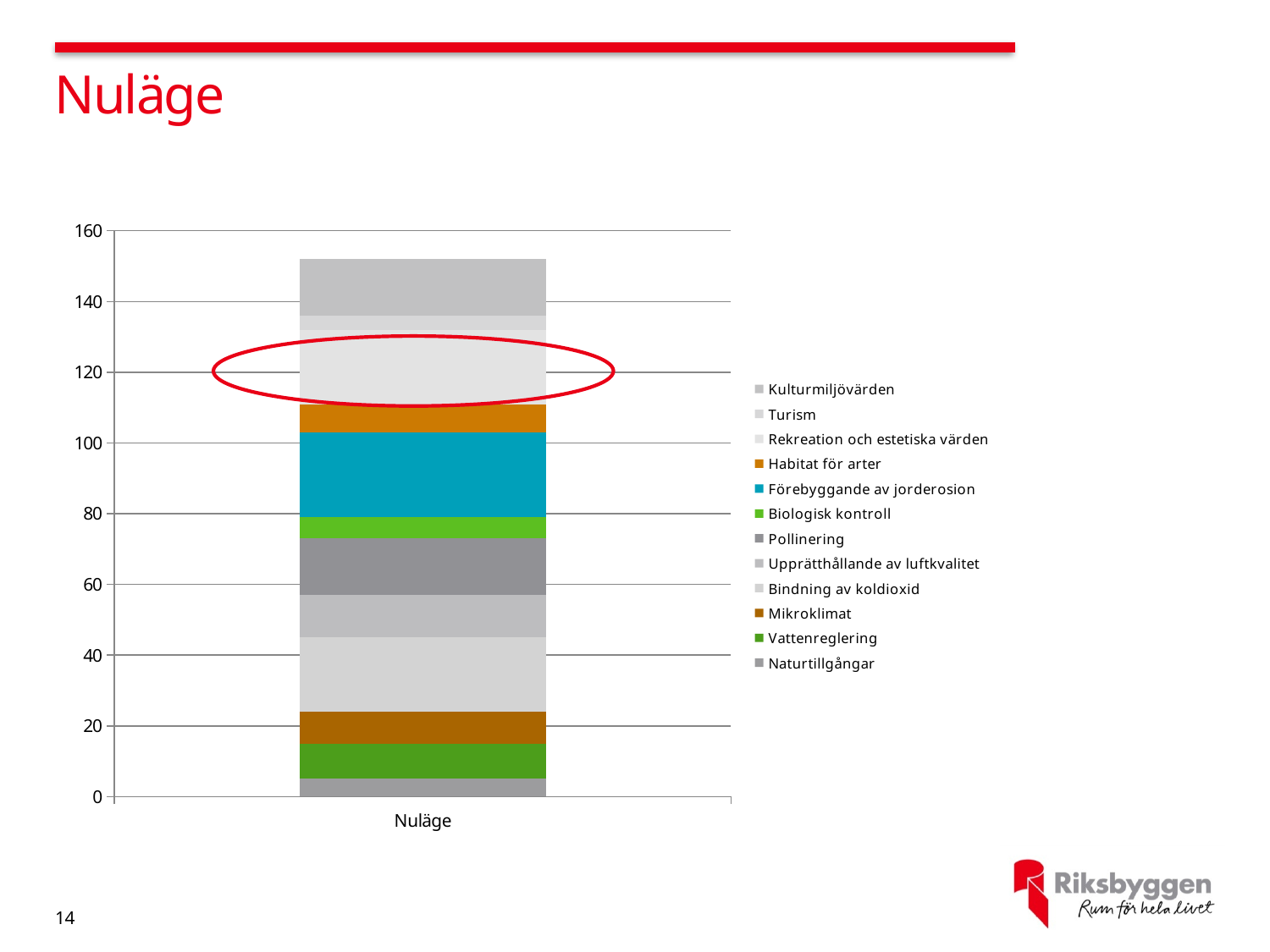
Is the total height of the stacked bar for Nuläge greater or less than 140? greater What kind of chart is shown on the slide? stacked bar chart Which series is listed last in the legend? Naturtillgångar What is the label of the single category on the x axis? Nuläge What is the highest value shown on the y axis? 160 How many categories are shown on the x axis of the chart? 1 Which series is listed first in the legend? Kulturmiljövärden How many series does the chart's legend list? 12 Is the total height of the stacked bar for Nuläge greater or less than 160? less